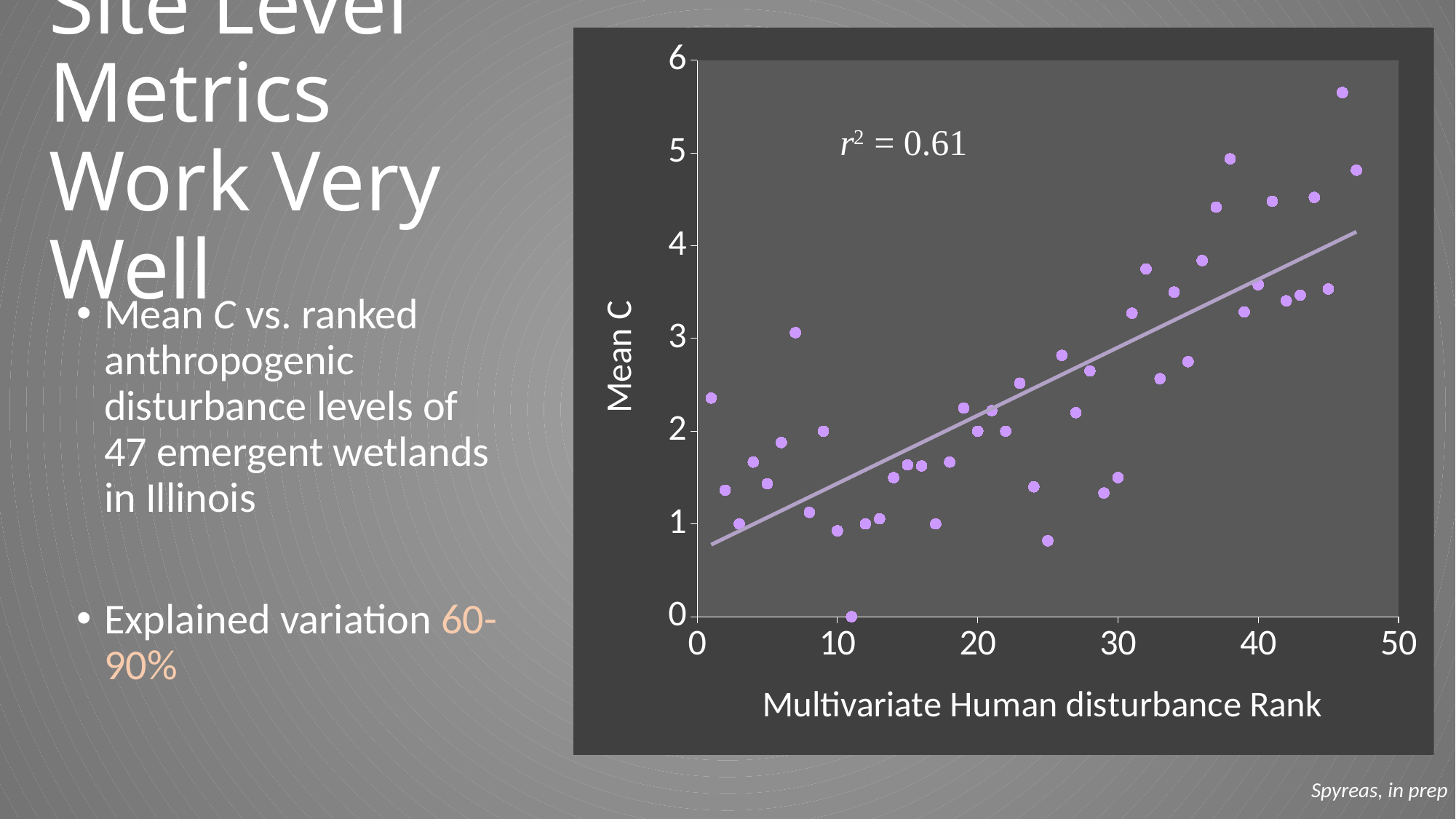
What is the highest value shown on the x axis of the chart? 50 How many wetland sites are plotted on the chart, according to the slide? 47 Is the Mean C value of the point at disturbance rank 1 greater or less than 2? greater What is the title of the x axis of the chart? Multivariate Human disturbance Rank What is the Mean C value of the lowest point on the chart, which sits on the x axis at rank 11? 0 What is the highest value shown on the y axis of the chart? 6 Do the Mean C values generally rise or fall as the Multivariate Human disturbance Rank increases? rise Is the Mean C value of the point at disturbance rank 25 greater or less than 1? less What is the title of the y axis of the chart? Mean C Is the Mean C value of the highest point on the chart greater or less than 5? greater What is the r² value printed on the chart? 0.61 What kind of chart is shown on the slide? scatter plot